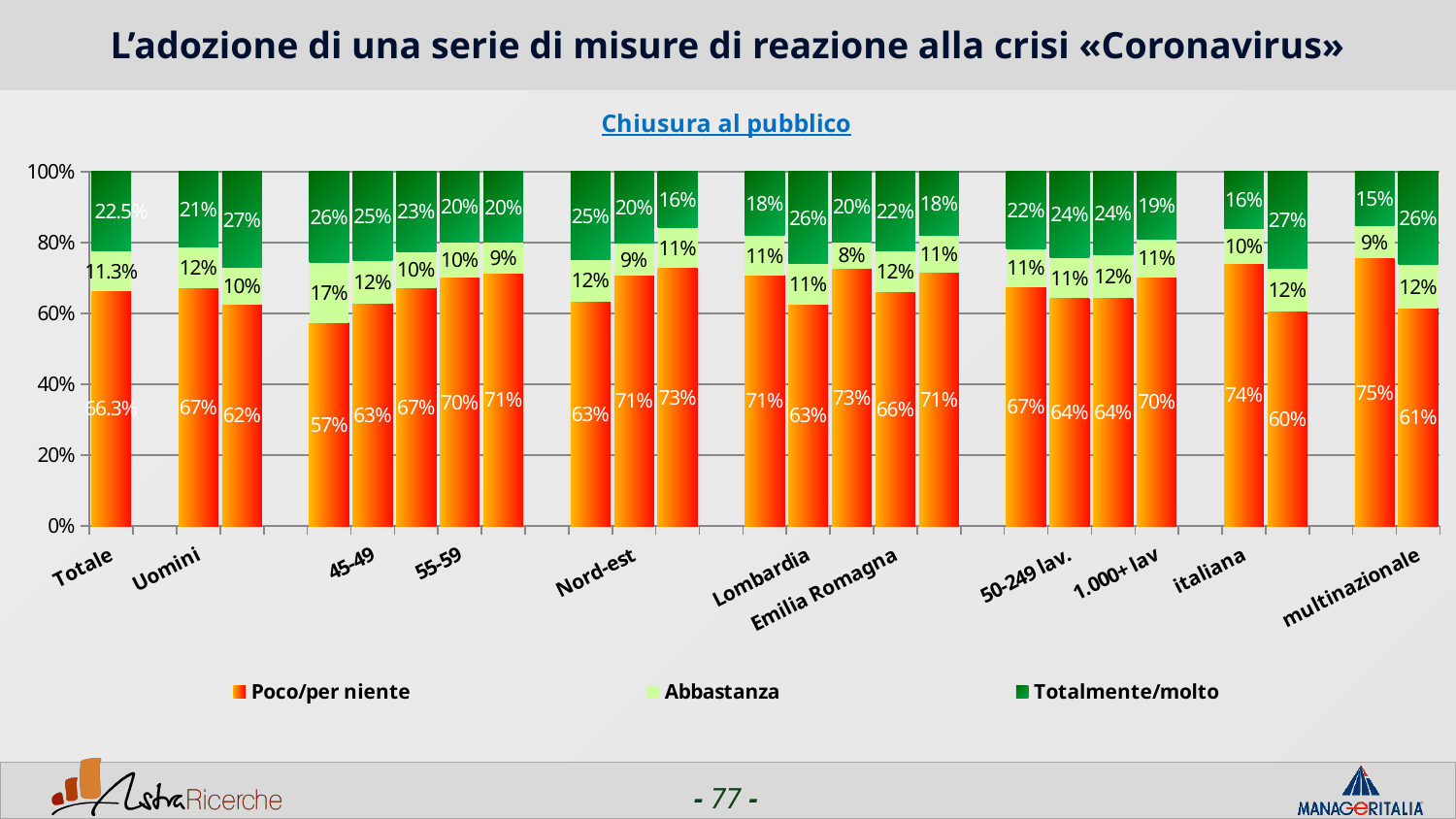
What is the Poco/per niente value for Uomini? 67% What percentage of the Totale group answered Poco/per niente for Chiusura al pubblico? 66.3% What is the title of the chart? Chiusura al pubblico What is the Abbastanza value for Uomini? 12% What kind of chart is shown on the slide? Stacked bar chart What is the Totalmente/molto value for Uomini? 21% What is the Totalmente/molto value for the Totale category? 22.5% Is the Poco/per niente value for Totale greater or less than 60%? greater For the Totale category, what is the difference between the Totalmente/molto value and the Abbastanza value? 11.2 percentage points How many series does the legend list? 3 Which has the larger Poco/per niente value, Totale or Uomini? Uomini What is the Abbastanza value for the Totale category? 11.3%